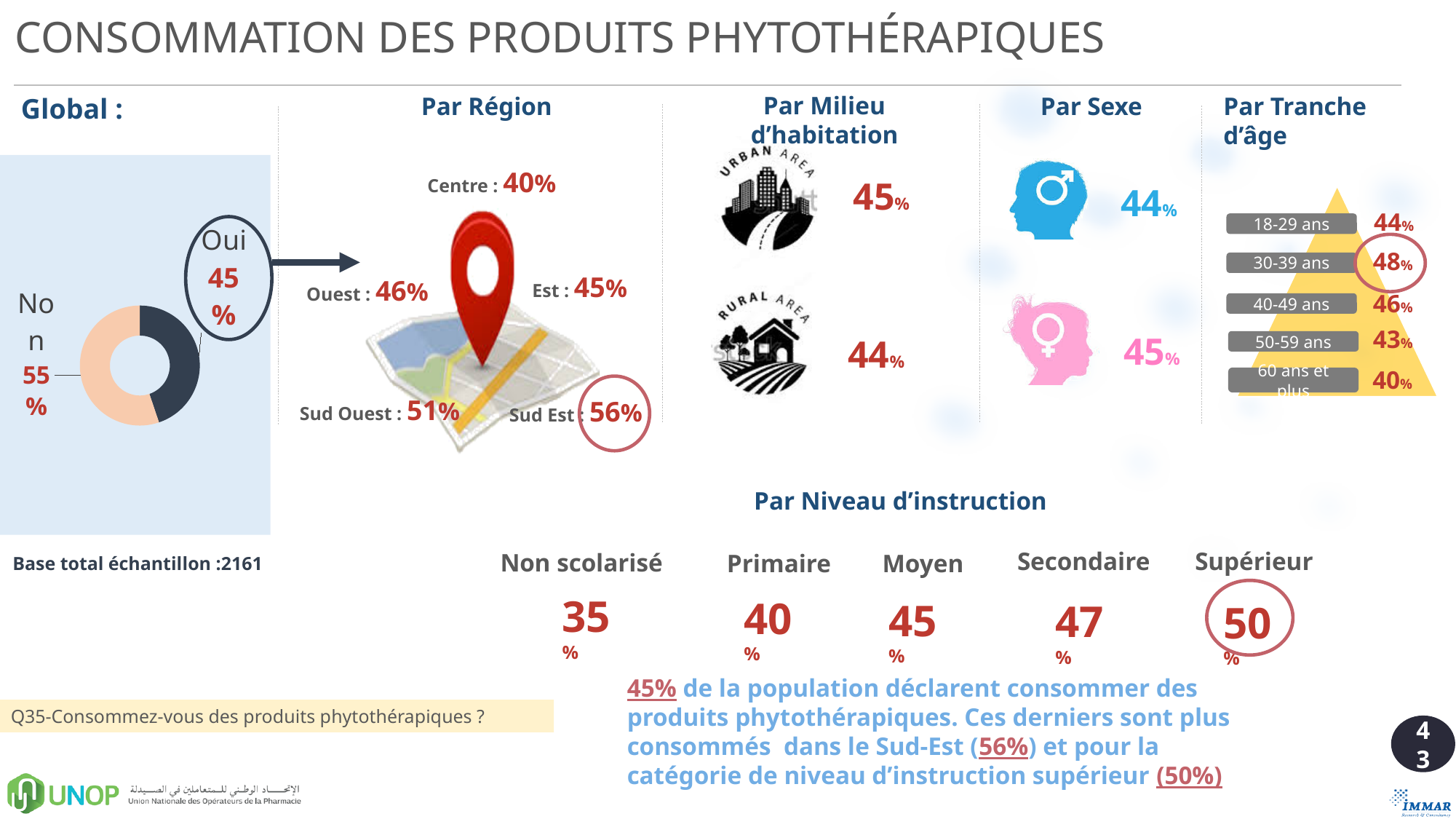
In the Global donut chart, what share of respondents answered Non? 55% In the Global donut chart, which answer has the larger share, Oui or Non? Non How many slices does the Global donut chart have? 2 In the Par Tranche d'âge pyramid, what is the value for 30-39 ans? 48% In the Par Tranche d'âge pyramid, which age group has the lowest value? 60 ans et plus (40%) In the Par Région section, which region has the lowest consumption rate? Centre (40%) In the Par Région section, which region has the highest consumption rate? Sud Est (56%) What is the base total échantillon stated on the slide? 2161 In the Par Niveau d'instruction section, what is the difference between Supérieur and Non scolarisé? 15% What kind of chart is shown in the Global section? Donut (pie) chart In the Global donut chart, what is the difference between the Non share and the Oui share? 10% In the Global donut chart, what share of respondents answered Oui? 45%